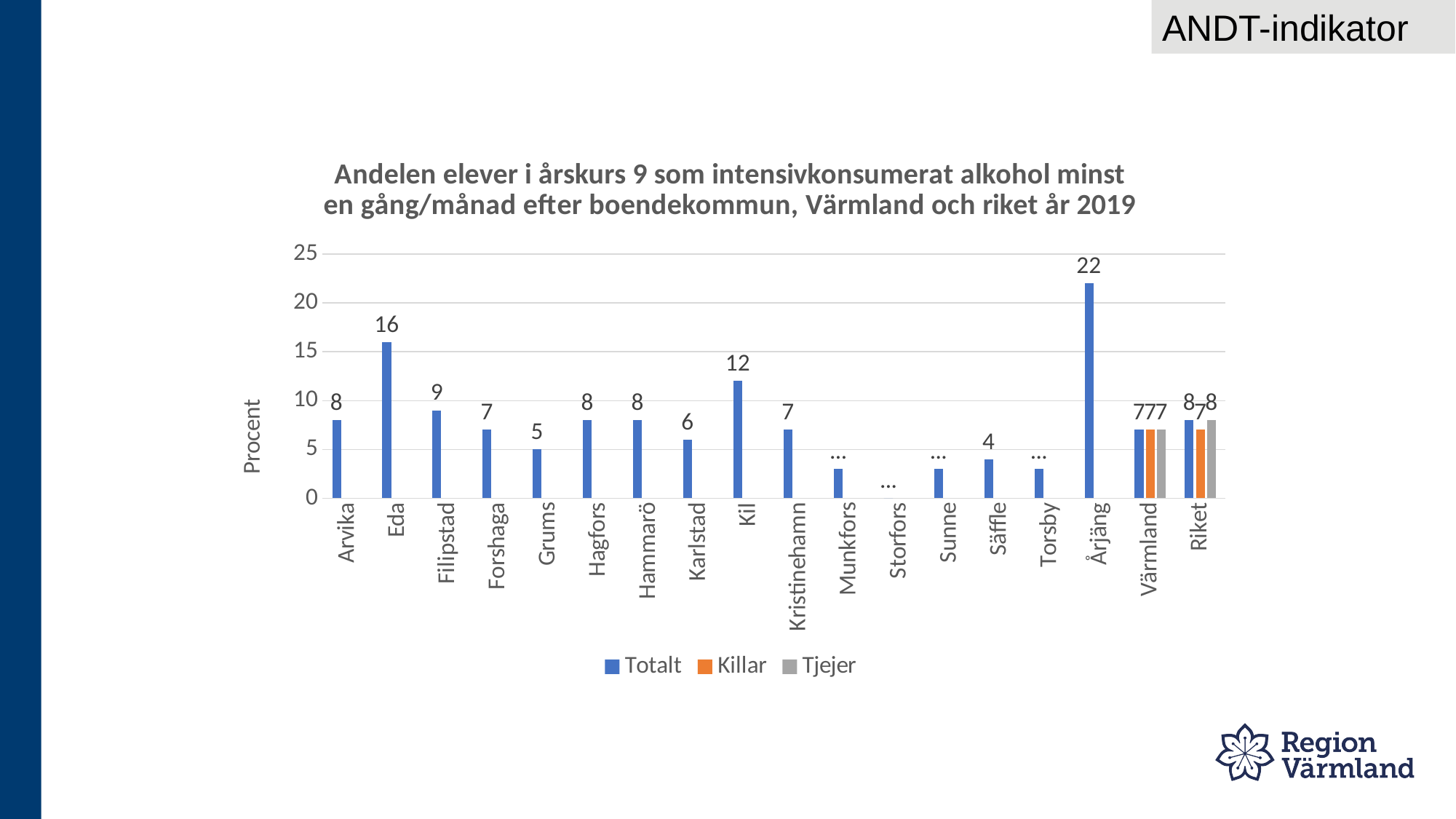
Which municipality has the highest Totalt value? Årjäng What is the Totalt value for Eda? 16 How many categories are shown on the x axis? 18 How many series does the legend list? 3 What is the Killar value for Riket? 7 What is the Totalt value for Kil? 12 What is the label of the y axis? Procent Among the municipalities with a printed Totalt value, which has the lowest? Säffle Is the Totalt value for Årjäng greater or less than 20? greater Which has a larger Totalt value, Kil or Filipstad? Kil What kind of chart is shown on the slide? Bar chart What is the difference between the Totalt values for Årjäng and Eda? 6